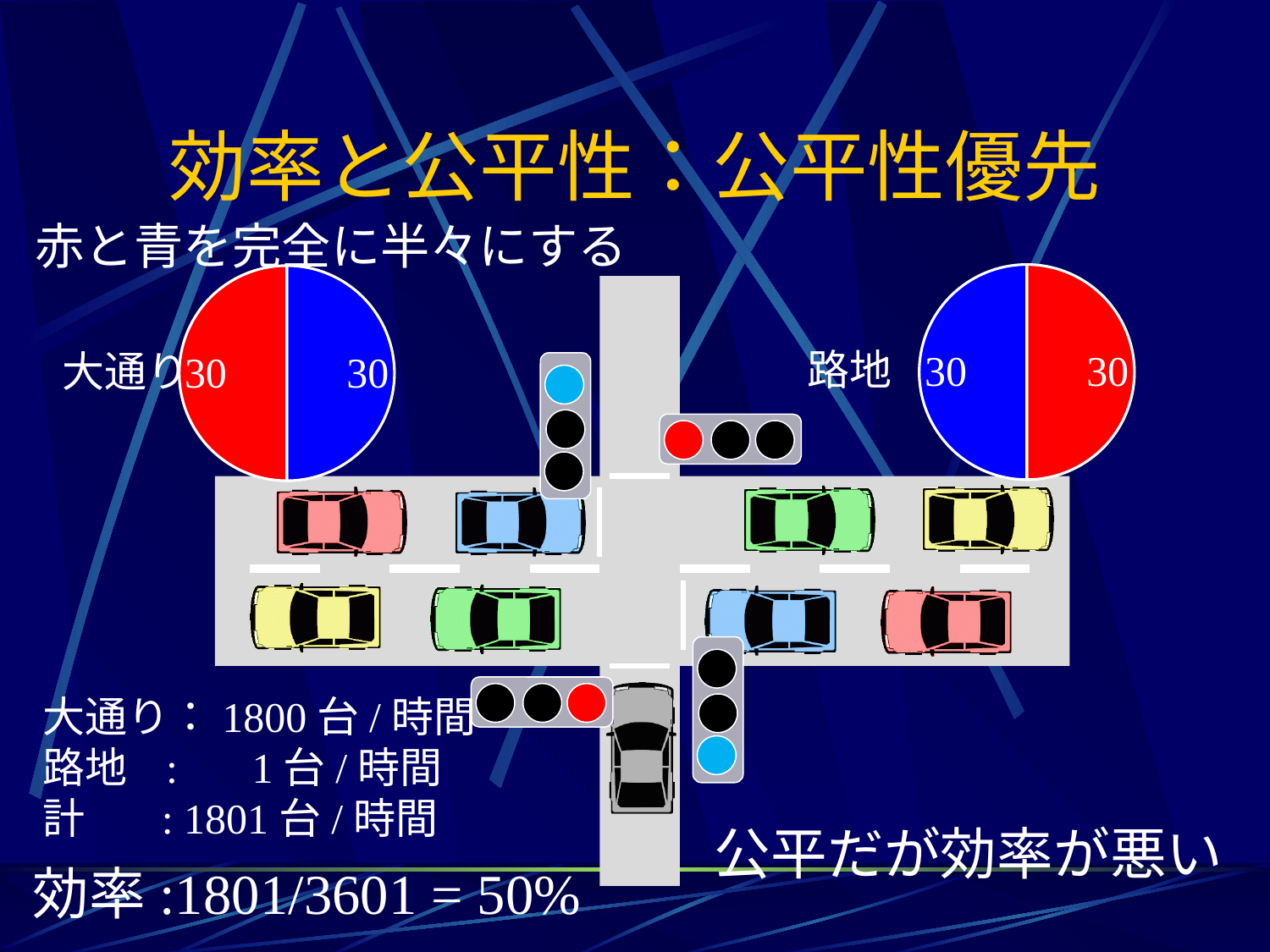
In the 路地 pie chart, what value is printed on the red slice? 30 What two colours are used for the slices in the 路地 pie chart? blue and red In the 大通り pie chart, what value is printed on the blue slice? 30 What kind of chart is the 路地 chart on the right of the slide? pie chart In the 路地 pie chart, what value is printed on the blue slice? 30 In the 大通り pie chart, what share of the whole does the red slice represent? 50% In the 大通り pie chart, what value is printed on the red slice? 30 In the 路地 pie chart, what share of the whole does the blue slice represent? 50% How many slices does the 路地 pie chart have? 2 In the 大通り pie chart, what is the difference between the red slice value and the blue slice value? 0 What kind of chart is the 大通り chart on the left of the slide? pie chart How many slices does the 大通り pie chart have? 2